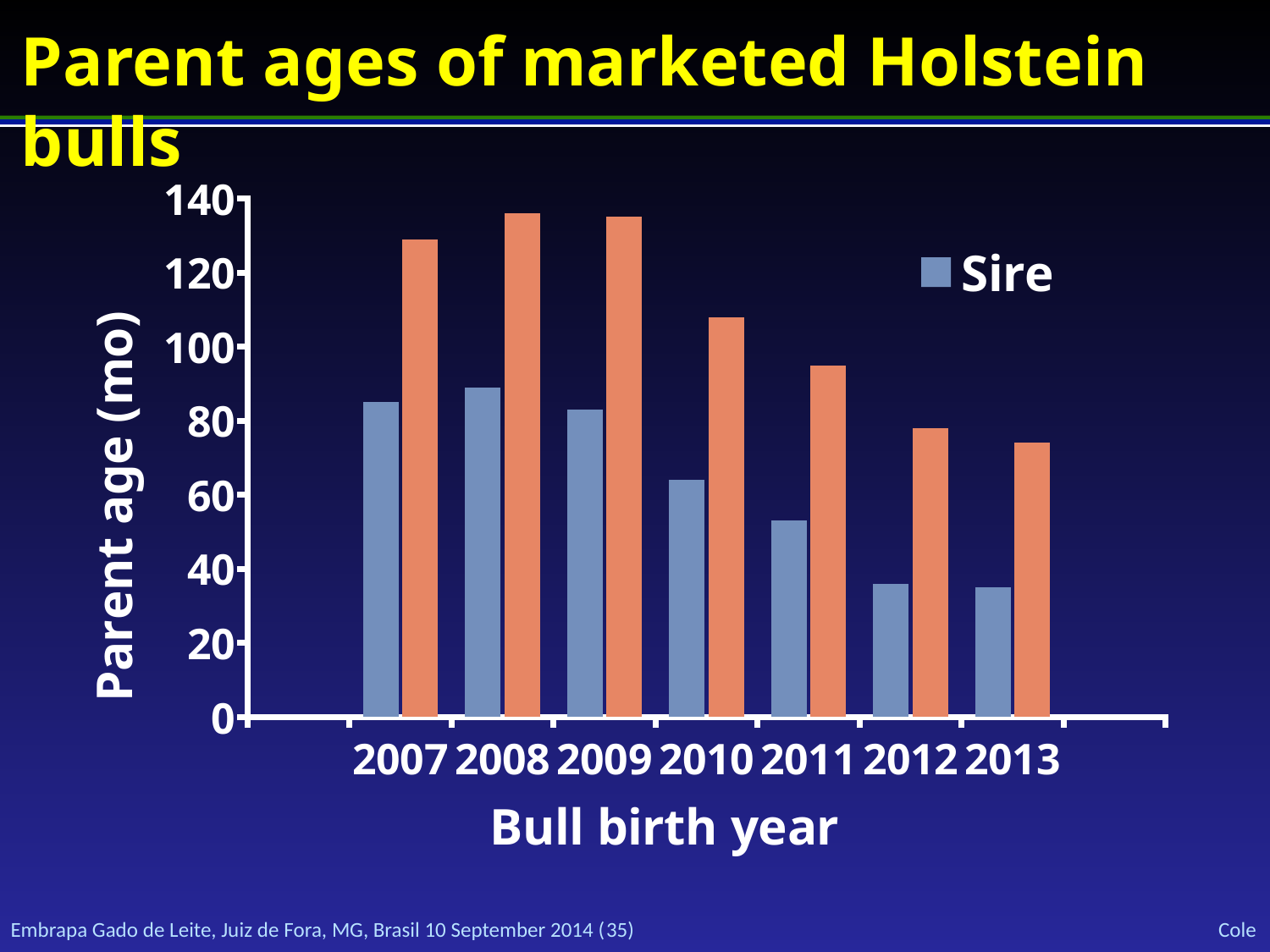
Is the Sire value for 2007 greater or less than 80? greater Is the Sire value for 2011 greater or less than 60? less Is the Sire value for 2010 greater or less than 80? less What kind of chart is shown on the slide? bar chart How many bull birth years are shown on the x axis? 7 Which is larger, the Sire value for 2007 or the Sire value for 2011? 2007 Which bull birth year has the highest Sire value? 2008 What is the title of the x axis? Bull birth year What is the title of the y axis? Parent age (mo) How many series does the legend list? 1 Do the Sire values generally rise or fall from 2007 to 2013? fall